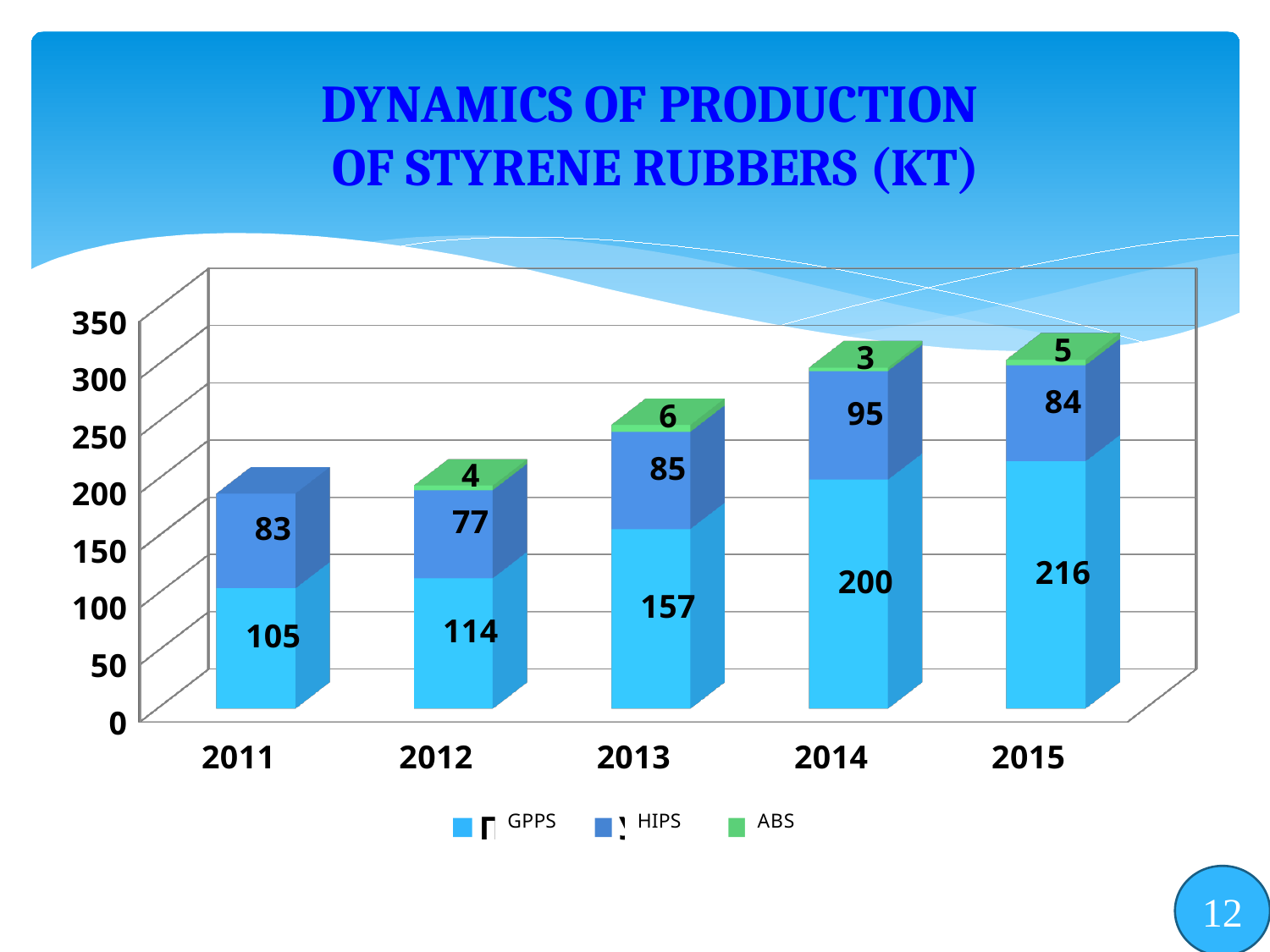
What is the GPPS value for 2013? 157 What is the HIPS value for 2014? 95 Which year has the highest GPPS value? 2015 What is the difference between the GPPS values for 2015 and 2014? 16 What is the total of the stacked bar for 2013? 248 How many years are shown on the x axis? 5 Which year has the lowest GPPS value? 2011 Which is larger, the HIPS value for 2013 or the HIPS value for 2015? 2013 How many series does the legend list? 3 What kind of chart is shown on the slide? Stacked bar chart What is the total of the stacked bar for 2015? 305 What is the ABS value for 2012? 4